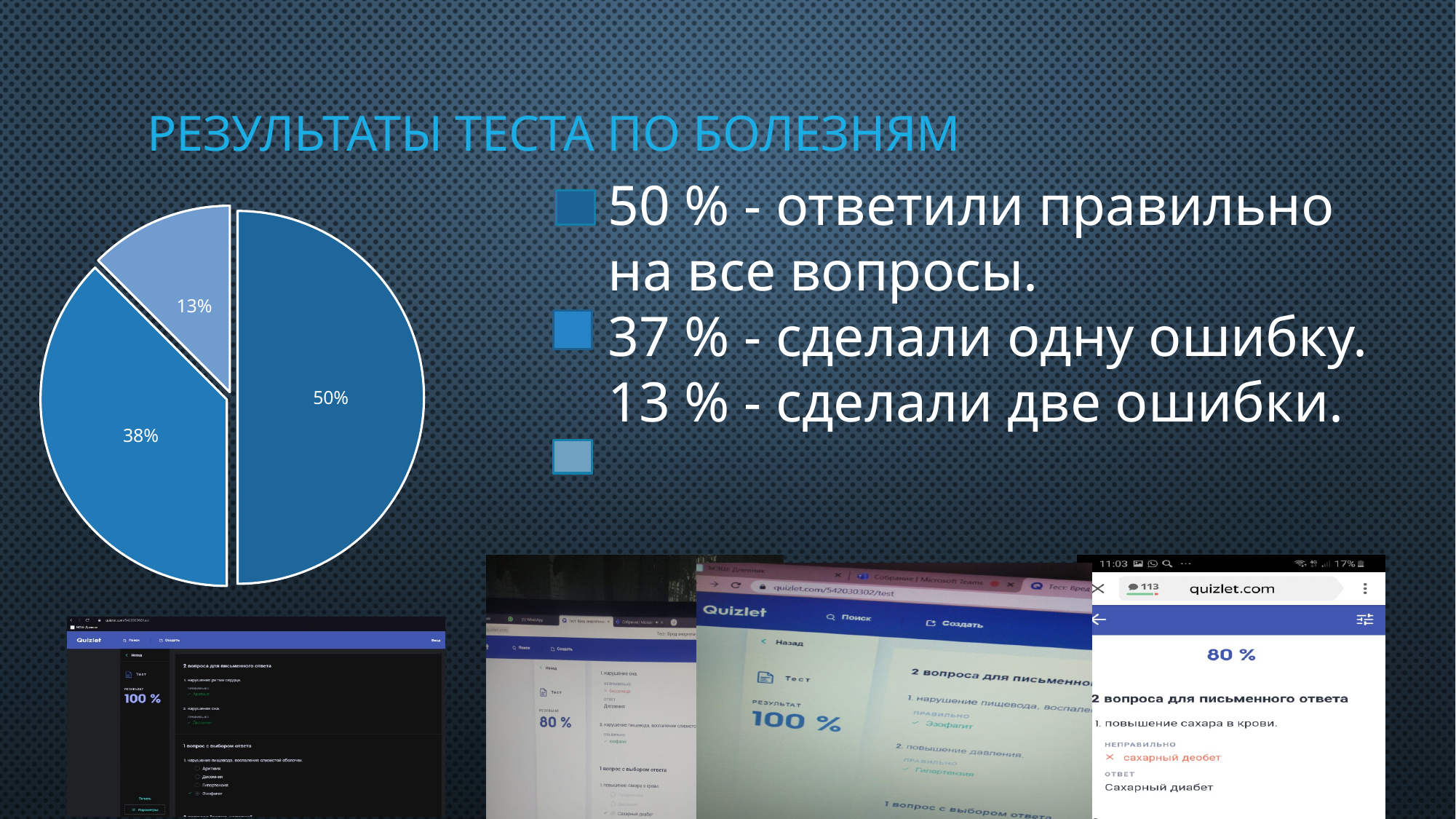
What percentage label appears on the medium-blue slice of the pie chart? 38% According to the slide text, what percentage of students made two mistakes? 13 % What is the title of the slide containing the pie chart? РЕЗУЛЬТАТЫ ТЕСТА ПО БОЛЕЗНЯМ How many slices does the pie chart have? 3 What is the difference in percentage points between the 50% slice and the 13% slice? 37 What percentage is shown on the smallest slice of the pie chart? 13% Which slice is larger: the one labelled 38% or the one labelled 13%? 38% What share of the pie is labelled for the slice representing those who answered all questions correctly (dark blue)? 50% What percentage is shown on the largest slice of the pie chart? 50% What kind of chart is shown on the slide? pie chart What percentage label appears on the light-blue slice of the pie chart? 13% What is the difference in percentage points between the 38% slice and the 13% slice? 25